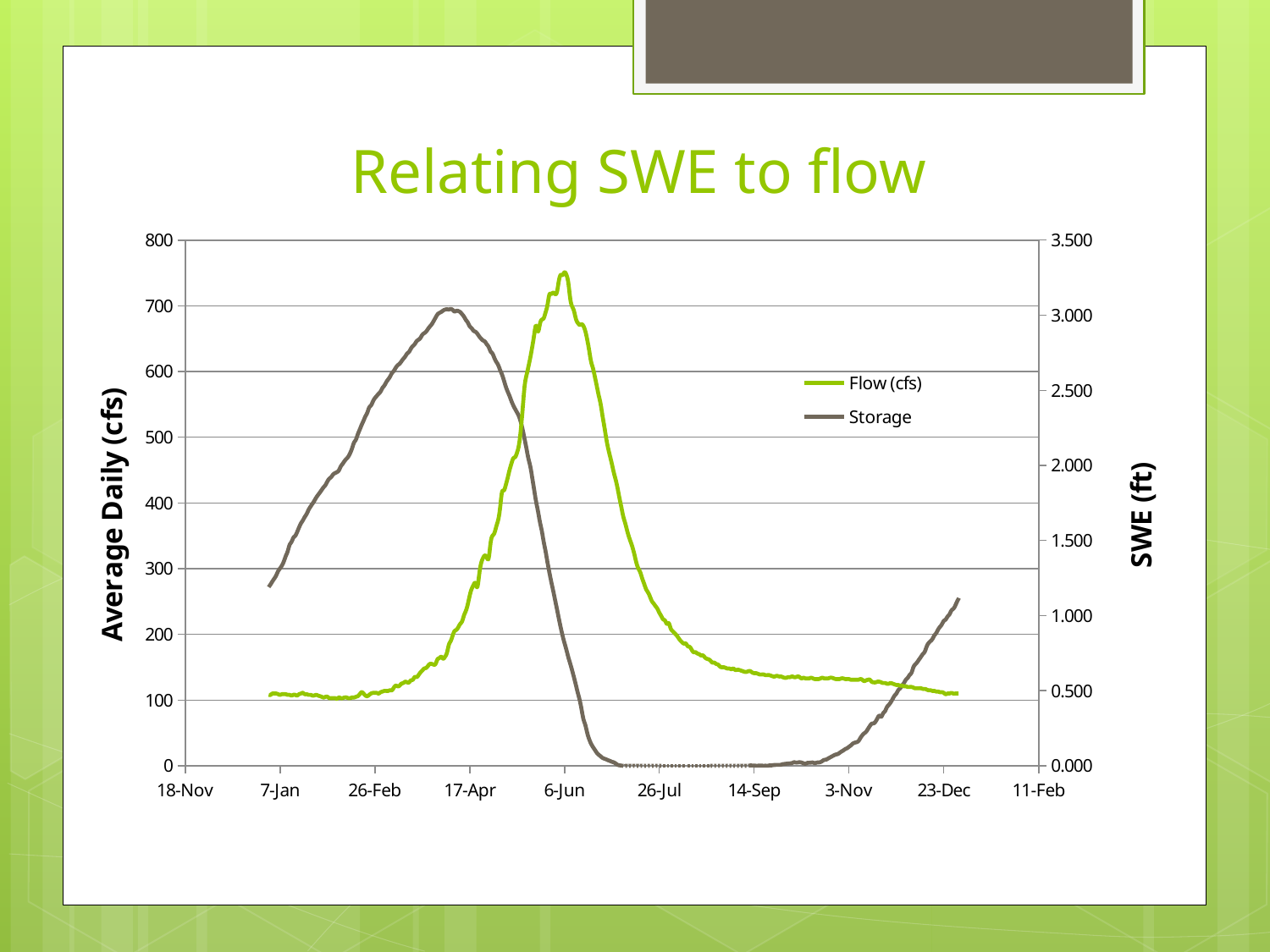
Is the Flow (cfs) value at 14-Sep greater or less than 200? less What kind of chart is shown on the slide? line chart What is the title of the chart? Relating SWE to flow How many series does the legend list? 2 Does the Flow (cfs) series rise or fall between 6-Jun and 23-Dec? fall Is the peak value of the Flow (cfs) series greater or less than 700? greater Is the peak value of the Storage series greater or less than 2.500 on the SWE (ft) axis? greater Which series reaches its peak earlier in the year, Flow (cfs) or Storage? Storage What is the title of the right-hand vertical axis? SWE (ft) Does the Storage series rise or fall between 7-Jan and 17-Apr? rise